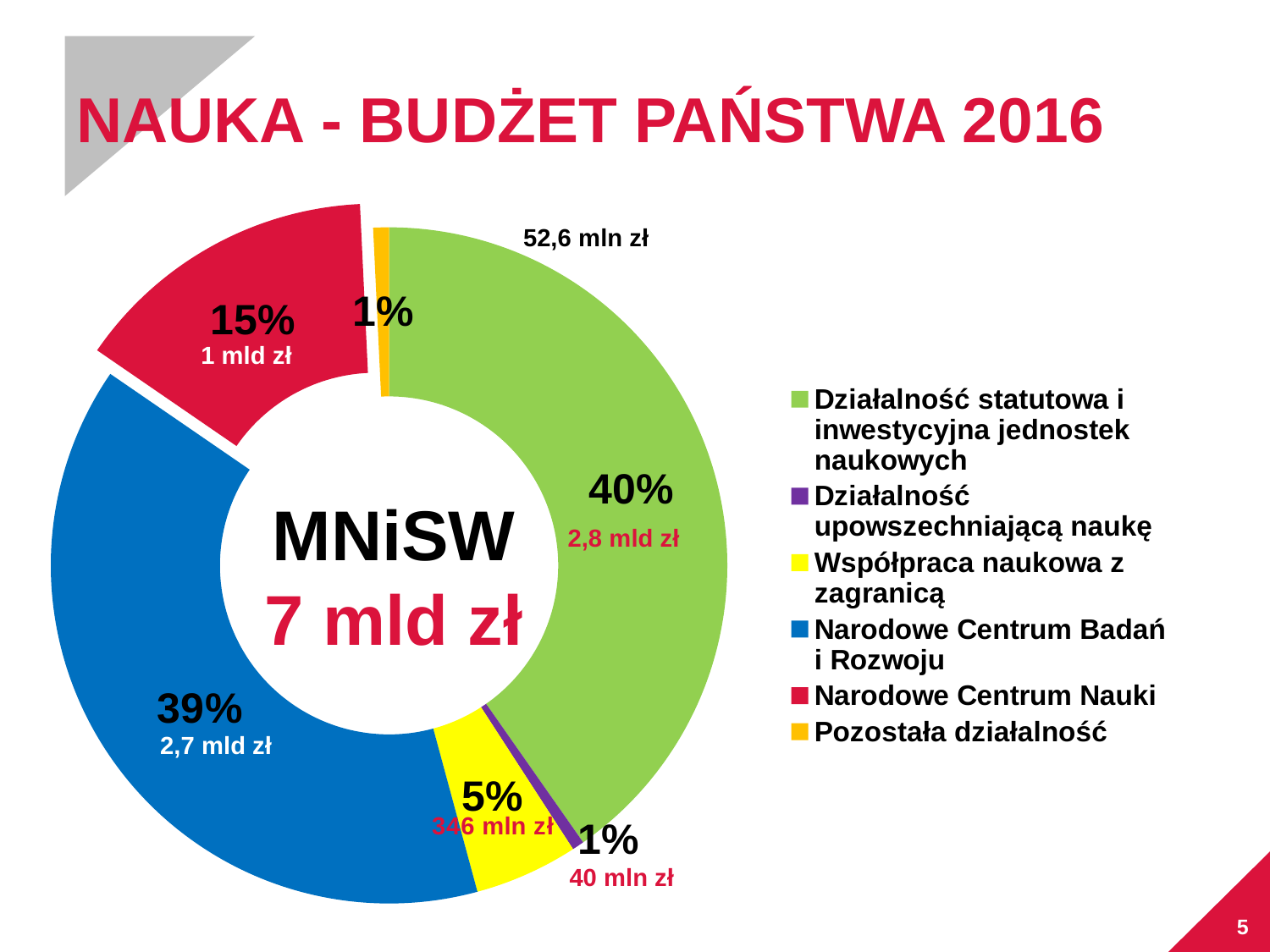
Which share is larger: Działalność statutowa i inwestycyjna jednostek naukowych or Narodowe Centrum Badań i Rozwoju? Działalność statutowa i inwestycyjna jednostek naukowych What total amount is shown in the centre of the chart? 7 mld zł What amount is shown for Pozostała działalność? 52,6 mln zł How many categories does the legend list? 6 What amount is shown for Współpraca naukowa z zagranicą? 346 mln zł What colour represents Narodowe Centrum Nauki in the chart? red What percentage share does Narodowe Centrum Badań i Rozwoju have in the chart? 39% What amount is shown for Działalność statutowa i inwestycyjna jednostek naukowych? 2,8 mld zł What amount is shown for Narodowe Centrum Nauki? 1 mld zł Which category has the largest share of the chart? Działalność statutowa i inwestycyjna jednostek naukowych What kind of chart is shown on the slide? doughnut (pie) chart What is the difference in percentage points between the share of Działalność statutowa i inwestycyjna jednostek naukowych and Narodowe Centrum Nauki? 25 percentage points